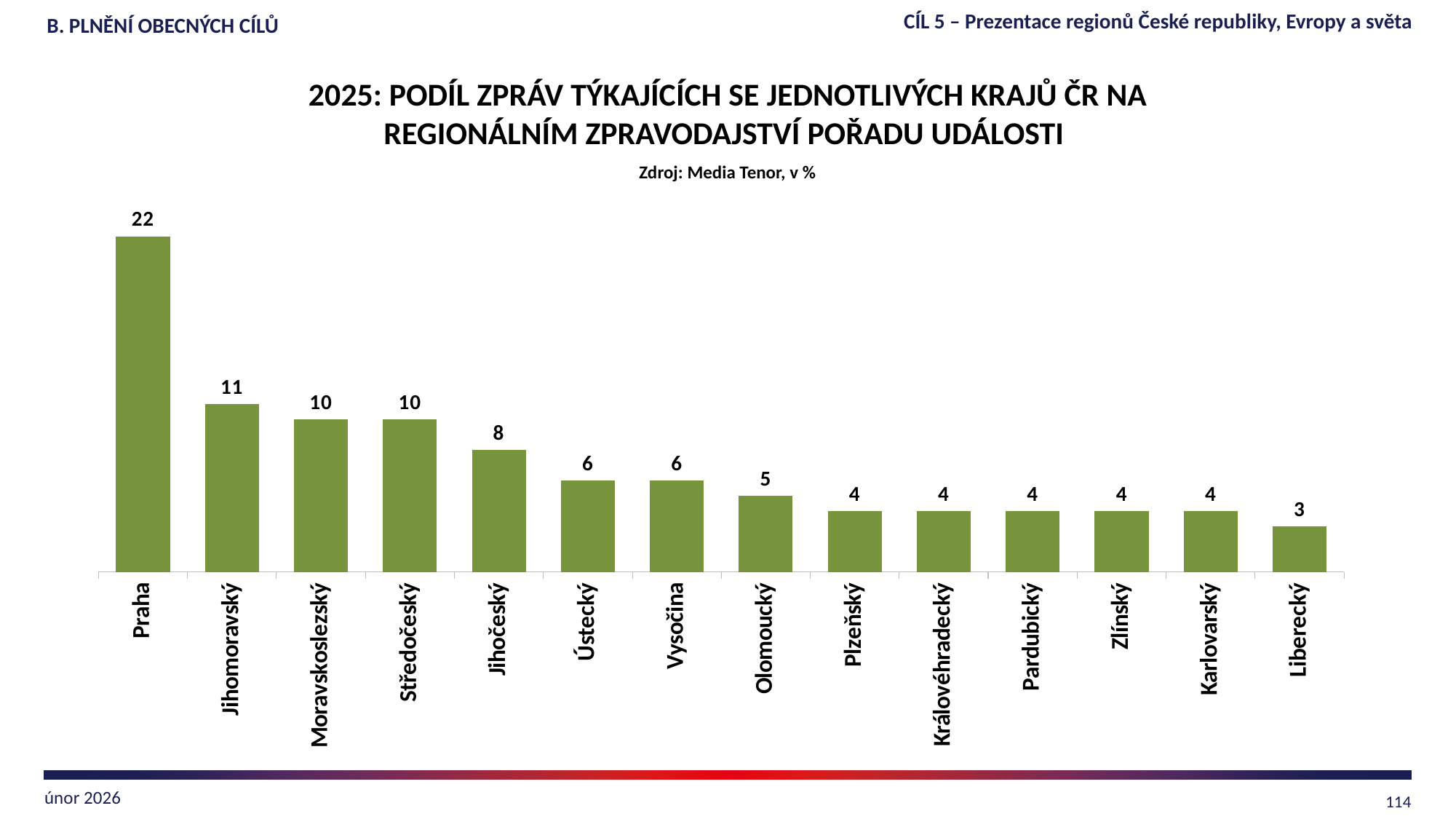
Which is larger, the value for Jihomoravský or the value for Středočeský? Jihomoravský What is the value for Praha? 22 What is the difference between the values for Praha and Jihomoravský? 11 Do the values rise or fall from left to right along the x axis? fall Which region has the highest value? Praha How many regions are shown on the chart? 14 What is the difference between the values for Ústecký and Liberecký? 3 What is the value for Jihočeský? 8 What kind of chart is this? bar chart What is the value for Olomoucký? 5 What source is cited below the chart title? Media Tenor, v % Which region has the lowest value? Liberecký